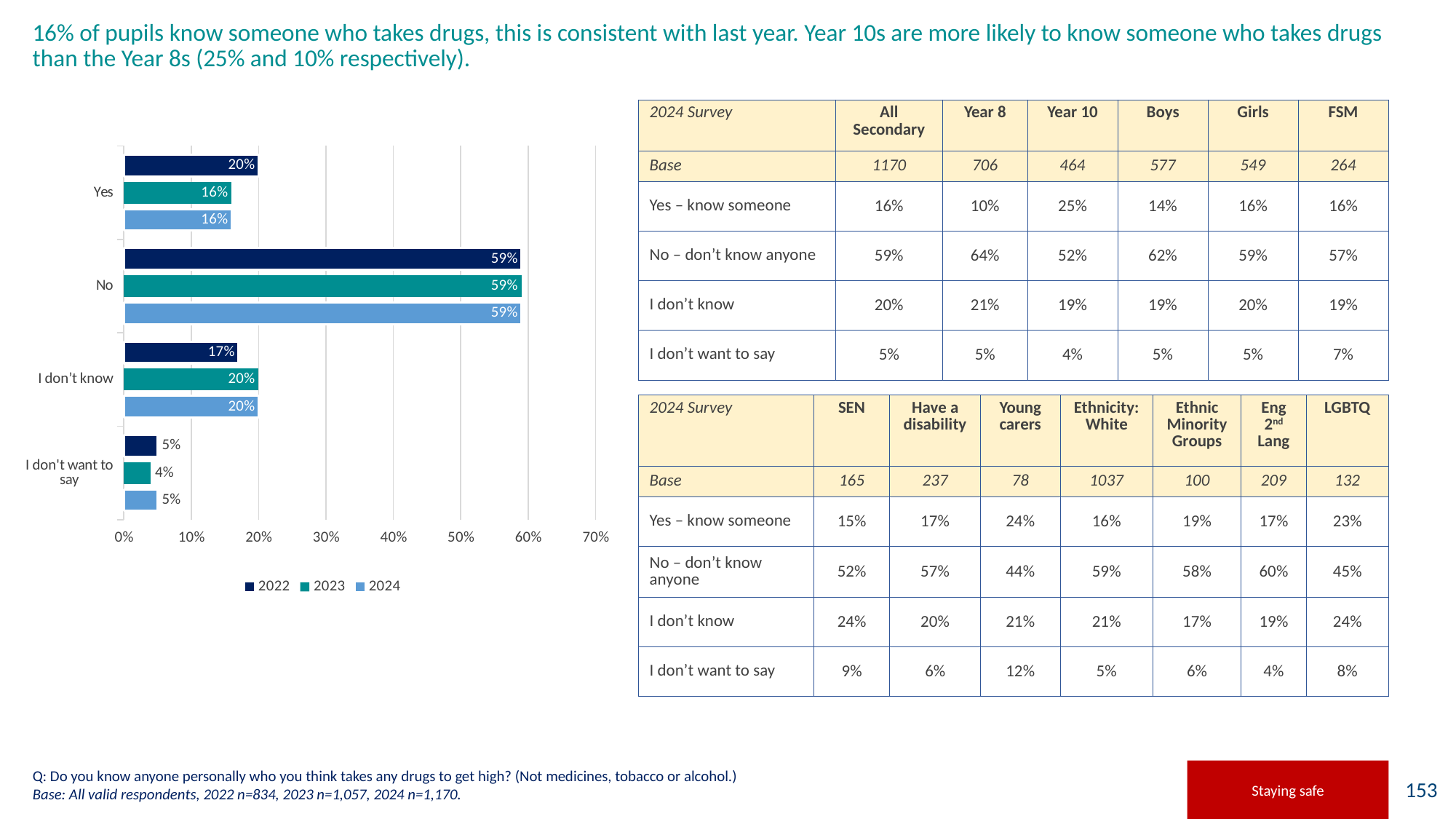
What is the 2022 value for "I don't know" in the bar chart? 17% How many series does the legend of the bar chart list? 3 Which years are listed in the legend of the bar chart? 2022, 2023, 2024 Which category has the highest value for 2024 in the bar chart? No How many categories are shown on the y axis of the bar chart? 4 What is the difference between the 2022 and 2024 values for "Yes" in the bar chart? 4% What is the 2023 value for "I don't want to say" in the bar chart? 4% What is the 2024 value for "Yes" in the bar chart? 16% Is the 2022 value for "Yes" larger or smaller than the 2023 value for "Yes" in the bar chart? larger What kind of chart is shown on the slide? Bar chart Which category has the lowest value for 2022 in the bar chart? I don't want to say Is the 2024 value for "No" greater or less than 50%? greater